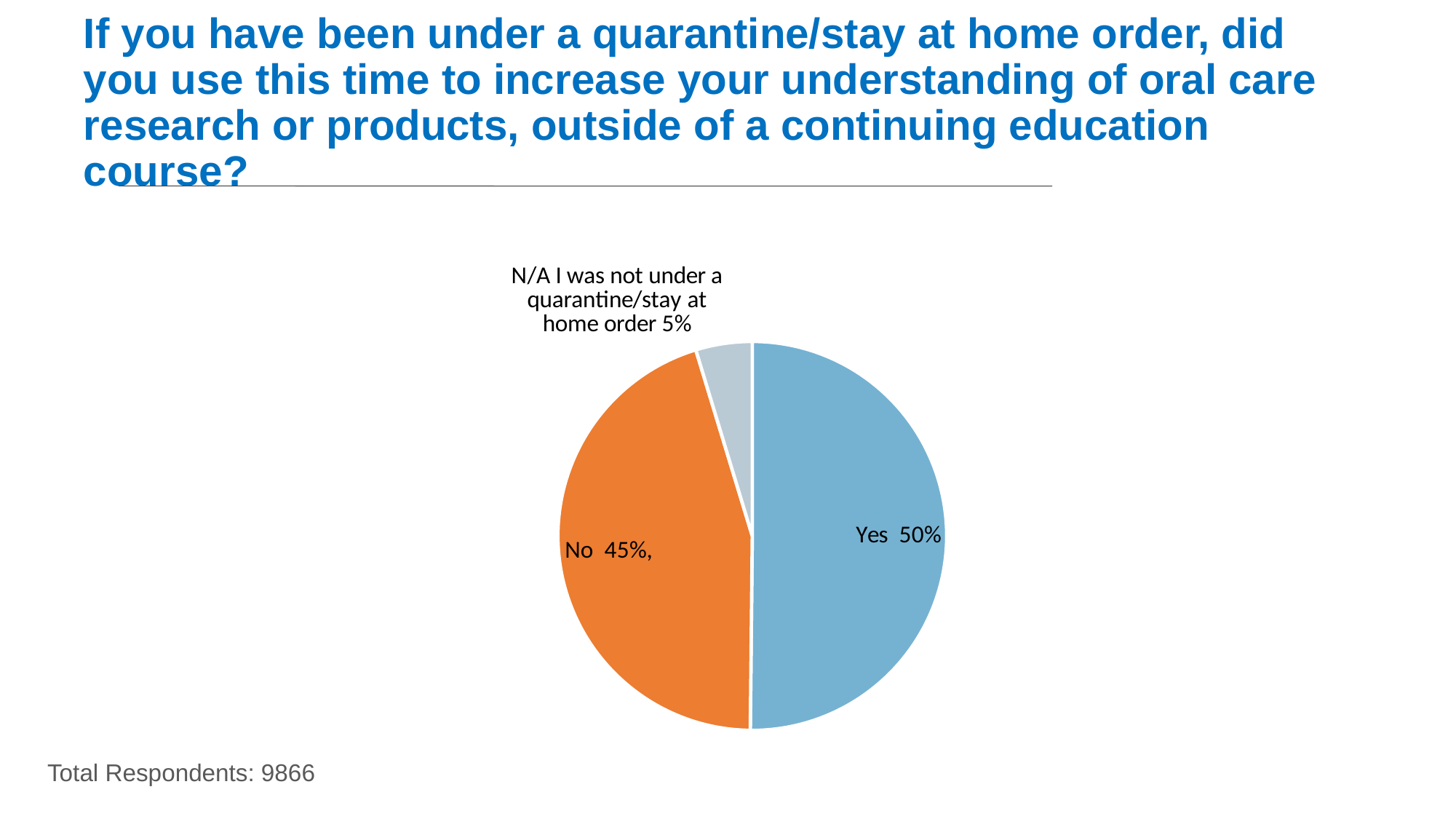
Which response has the largest share of the pie? Yes Which response has the smallest share of the pie? N/A I was not under a quarantine/stay at home order What percentage of respondents answered "No"? 45% What share of the pie does the "No" slice represent? 45% What percentage of respondents answered "N/A I was not under a quarantine/stay at home order"? 5% What percentage of respondents answered "Yes"? 50% How many slices does the pie chart have? 3 What colour is the "Yes" slice of the pie chart? blue What is the difference in percentage points between the "Yes" and "No" responses? 5 How many total respondents are reported on the slide? 9866 What type of chart is shown on the slide? pie chart Which is larger, the share for "No" or the share for "N/A I was not under a quarantine/stay at home order"? No